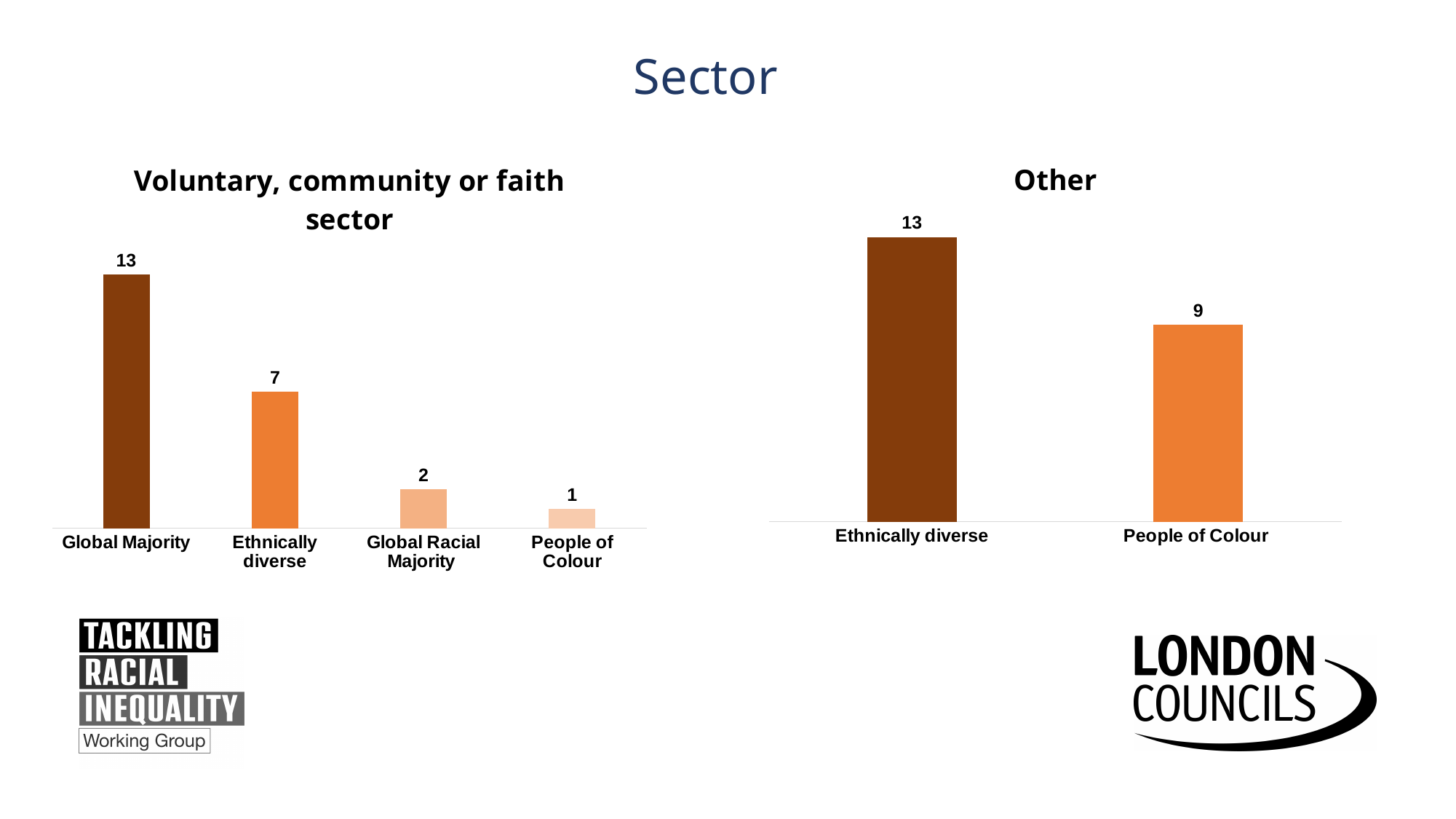
In the 'Other' chart, what is the difference between Ethnically diverse and People of Colour? 4 In the 'Voluntary, community or faith sector' chart, which category has the highest value? Global Majority In the 'Other' chart, what is the value for People of Colour? 9 In the 'Voluntary, community or faith sector' chart, which category has the lowest value? People of Colour What type of chart is the 'Other' chart? bar chart In the 'Voluntary, community or faith sector' chart, do the values rise or fall from left to right? fall In the 'Other' chart, which is larger: Ethnically diverse or People of Colour? Ethnically diverse In the 'Voluntary, community or faith sector' chart, how many categories are shown? 4 In the 'Other' chart, what is the value for Ethnically diverse? 13 In the 'Voluntary, community or faith sector' chart, what is the value for Ethnically diverse? 7 In the 'Voluntary, community or faith sector' chart, what is the difference between Global Majority and Ethnically diverse? 6 In the 'Voluntary, community or faith sector' chart, what is the value for Global Majority? 13